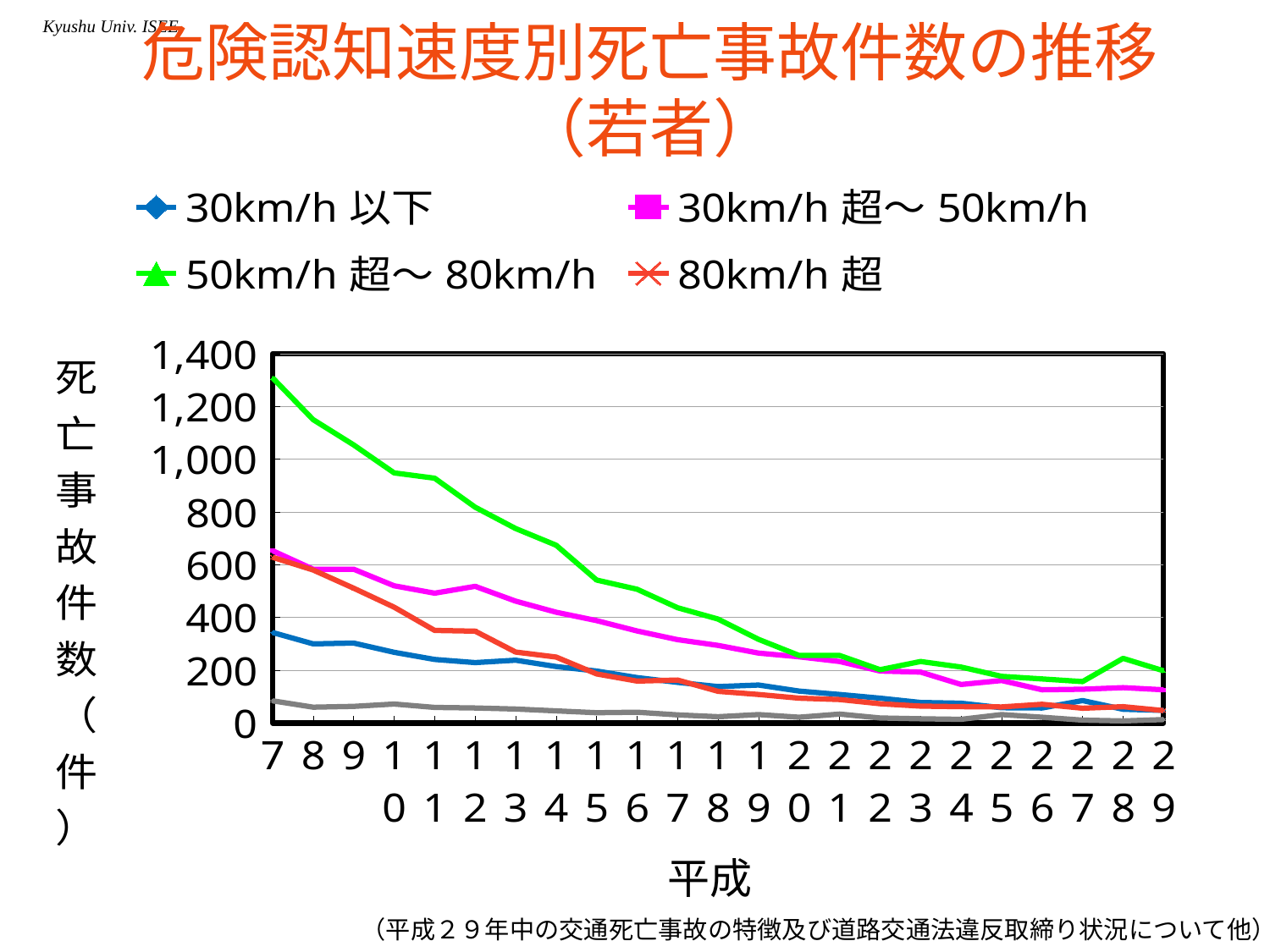
Is the value for the 50km/h 超～ 80km/h series at 平成7 greater or less than 1,200? greater What is the title of the chart on the slide? 危険認知速度別死亡事故件数の推移（若者） Does the value for the 50km/h 超～ 80km/h series generally rise or fall from 平成7 to 平成29? fall What colour is the line for the 80km/h 超 series? red At 平成7, which is larger: the value for 50km/h 超～ 80km/h or the value for 30km/h 以下? 50km/h 超～ 80km/h What kind of chart is shown on the slide? line chart Among the four series in the legend, which has the lowest value at 平成7? 30km/h 以下 Which series has the highest value at 平成7? 50km/h 超～ 80km/h How many years (points) are shown along the x axis, from 平成7 to 平成29? 23 Is the value for the 50km/h 超～ 80km/h series at 平成10 greater or less than 800? greater How many series does the legend list? 4 Is the value for the 30km/h 以下 series at 平成7 greater or less than 400? less